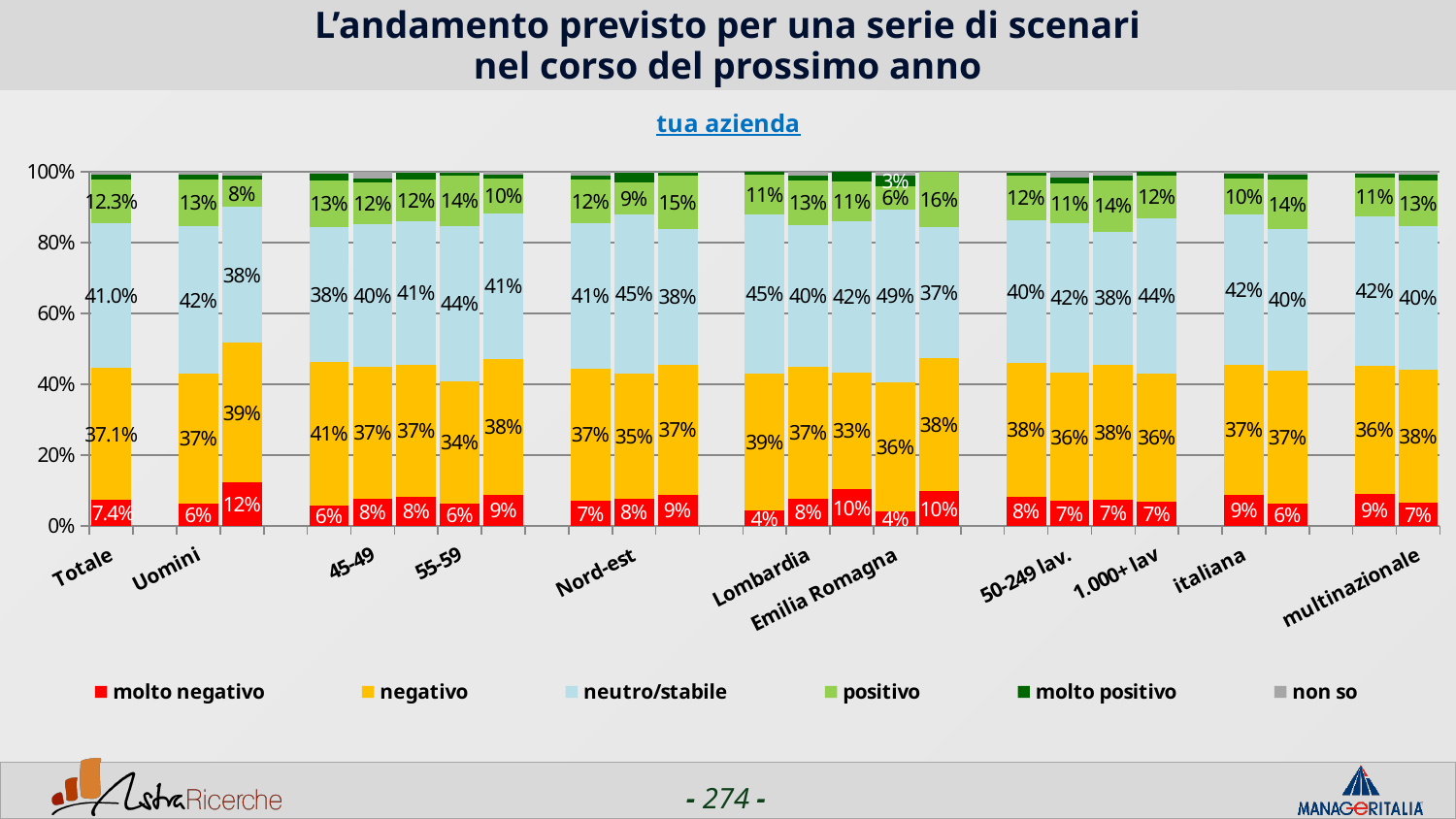
What is the value of the 'neutro/stabile' segment for the 'Emilia Romagna' bar? 49% How many series does the legend list? 6 What is the value of the 'negativo' segment for the 'Totale' bar? 37.1% In the 'Totale' bar, which is larger: the 'negativo' segment or the 'neutro/stabile' segment? neutro/stabile What is the value of the 'molto negativo' segment for the 'Totale' bar? 7.4% In the 'Totale' bar, what is the difference between the 'neutro/stabile' value and the 'negativo' value? 3.9 percentage points What is the value of the 'negativo' segment for the 'Uomini' bar? 37% What kind of chart is shown on the slide? Stacked bar chart What is the value of the 'neutro/stabile' segment for the 'Totale' bar? 41.0% What is the value of the 'neutro/stabile' segment for the 'Uomini' bar? 42% What is the value of the 'positivo' segment for the 'Totale' bar? 12.3% What is the subtitle shown above the chart? tua azienda